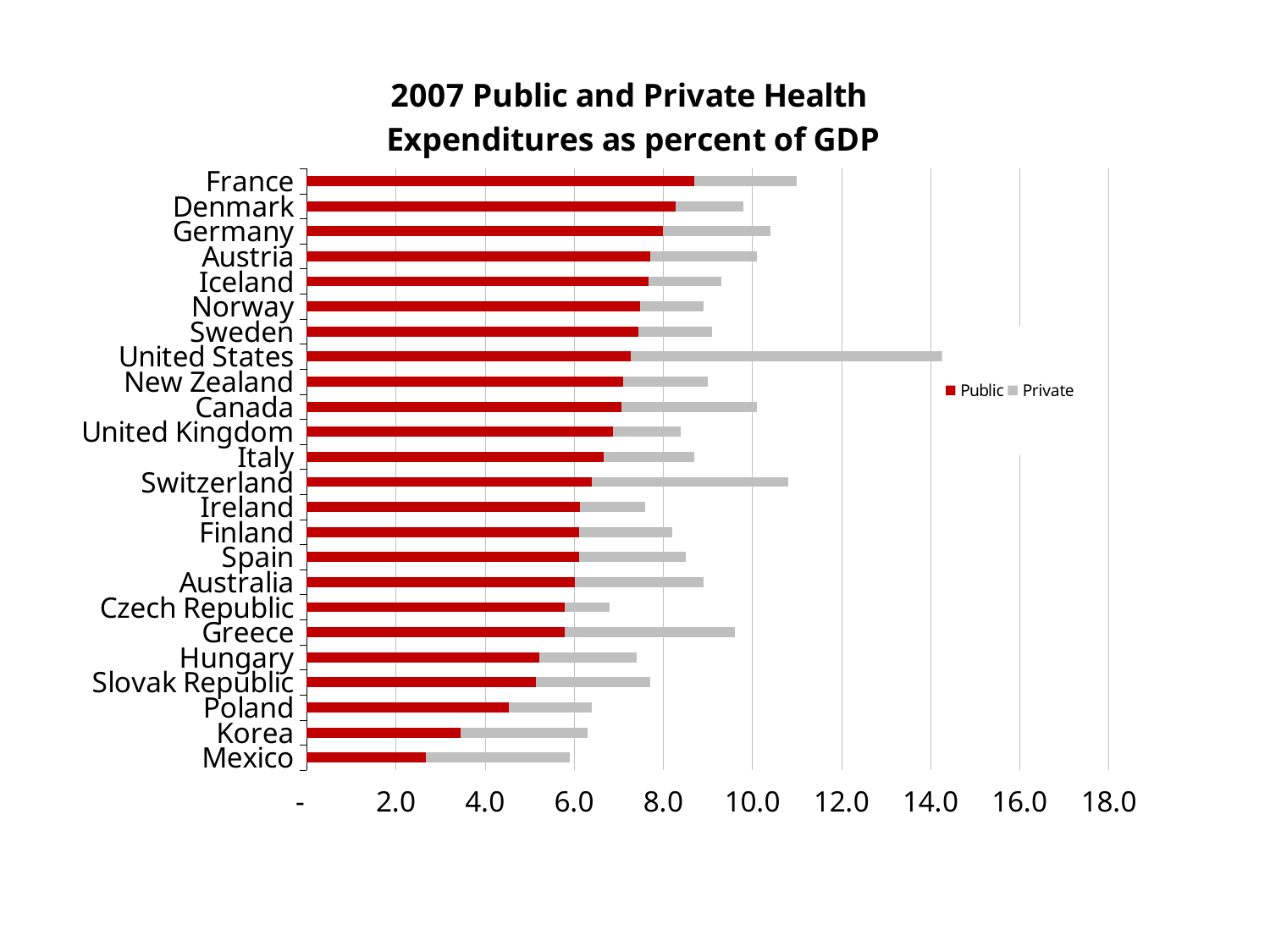
Is the public health expenditure for Korea greater or less than 4.0? less What kind of chart is shown on the slide? Stacked bar chart How many countries are listed on the chart? 24 Which country has the lowest public health expenditure as percent of GDP? Mexico Is the total health expenditure for Greece greater or less than 8.0? greater Which has the larger total health expenditure, Greece or the Czech Republic? Greece Which colour represents the Private series in the chart? Grey Is the total health expenditure for the United States greater or less than 12.0? greater Which country has the highest total health expenditure as percent of GDP? United States Which has the larger public health expenditure, Poland or Korea? Poland How many series does the legend list? 2 Which country has the highest public health expenditure as percent of GDP? France